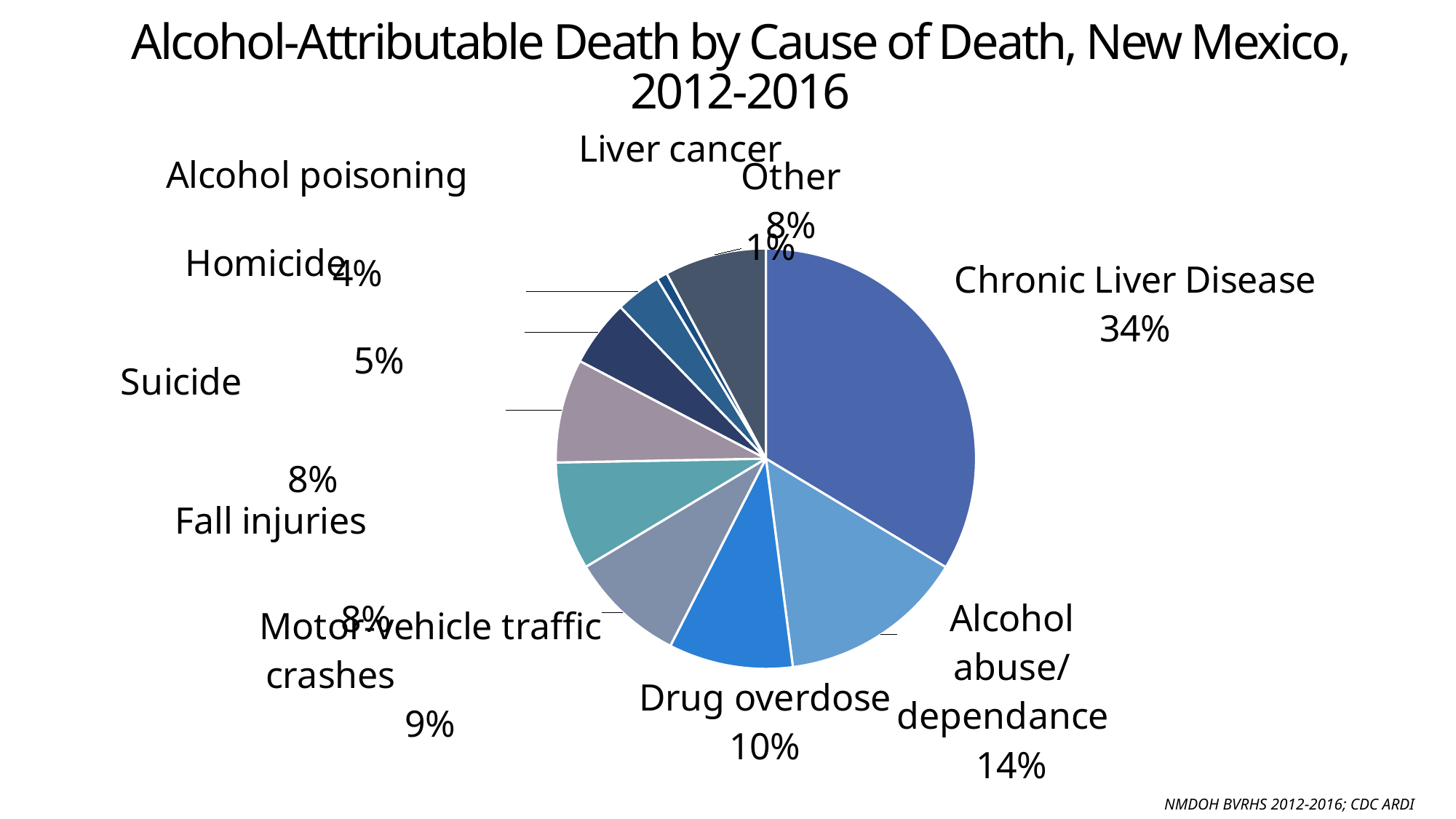
How many causes of death are shown as slices in the pie chart? 10 What percentage is shown for Motor-vehicle traffic crashes? 9% What percentage is shown for the Other category? 8% Which has a larger share, Drug overdose or Motor-vehicle traffic crashes? Drug overdose What percentage is shown for Liver cancer? 1% What share of alcohol-attributable deaths is attributed to Chronic Liver Disease? 34% Which cause of death accounts for the largest share of the pie? Chronic Liver Disease What percentage is shown for Alcohol abuse/dependance? 14% What percentage is shown for Drug overdose? 10% How many percentage points larger is the Chronic Liver Disease share than the Alcohol abuse/dependance share? 20 percentage points Which cause of death accounts for the smallest share of the pie? Liver cancer What kind of chart is shown on the slide? Pie chart